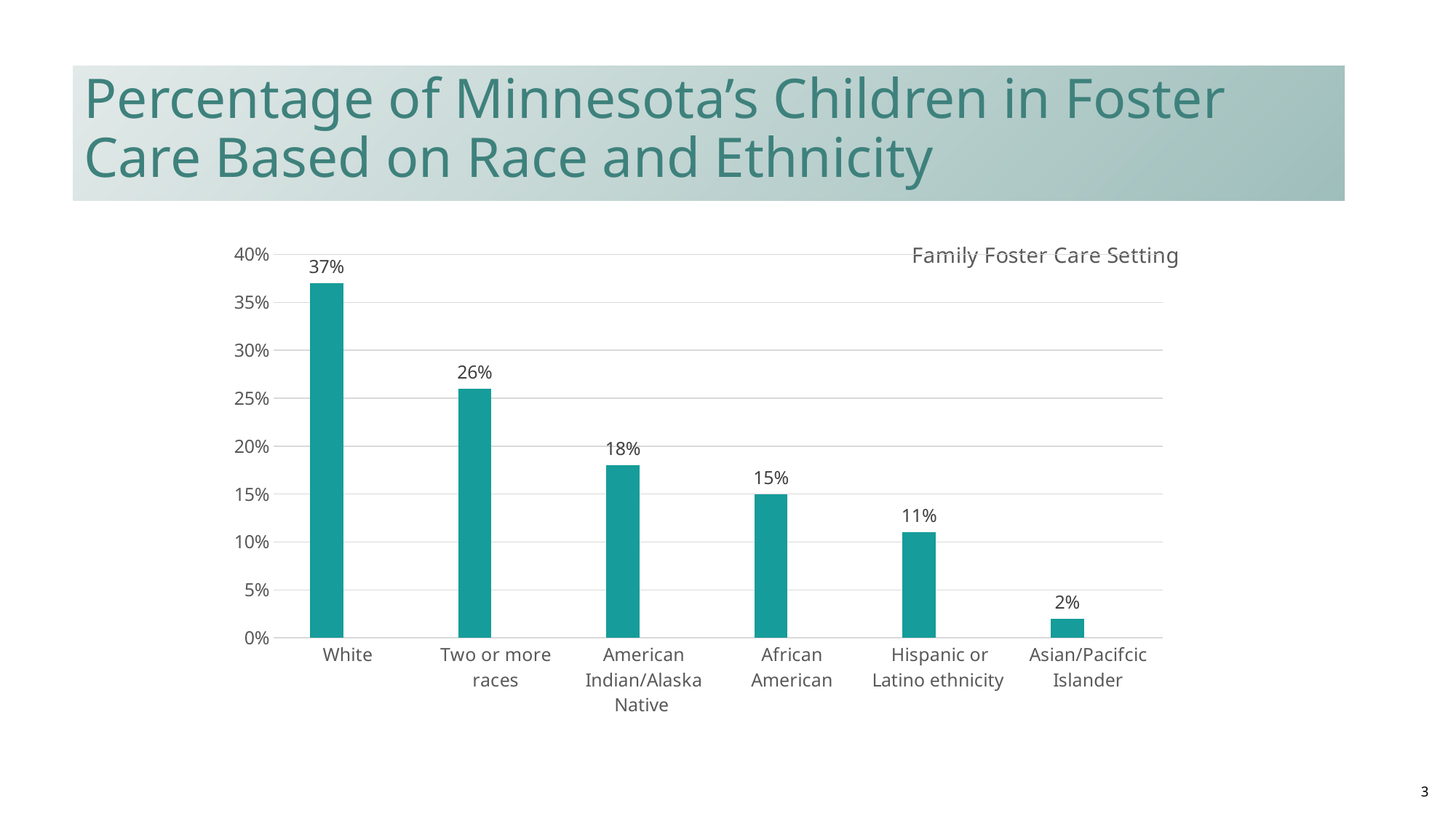
What kind of chart is shown on the slide? Bar chart What is the difference between the values for African American and Asian/Pacifcic Islander? 13% What percentage is shown for American Indian/Alaska Native? 18% What is the value for Two or more races? 26% Do the values rise or fall moving left to right along the x axis? Fall What is the value for Hispanic or Latino ethnicity? 11% What is the difference between the values for White and Two or more races? 11% Which category has the lowest percentage? Asian/Pacifcic Islander Which is larger, the value for African American or the value for Hispanic or Latino ethnicity? African American How many categories are shown on the x axis of the chart? 6 Which category has the highest percentage? White What percentage is shown for White children in the Family Foster Care Setting chart? 37%